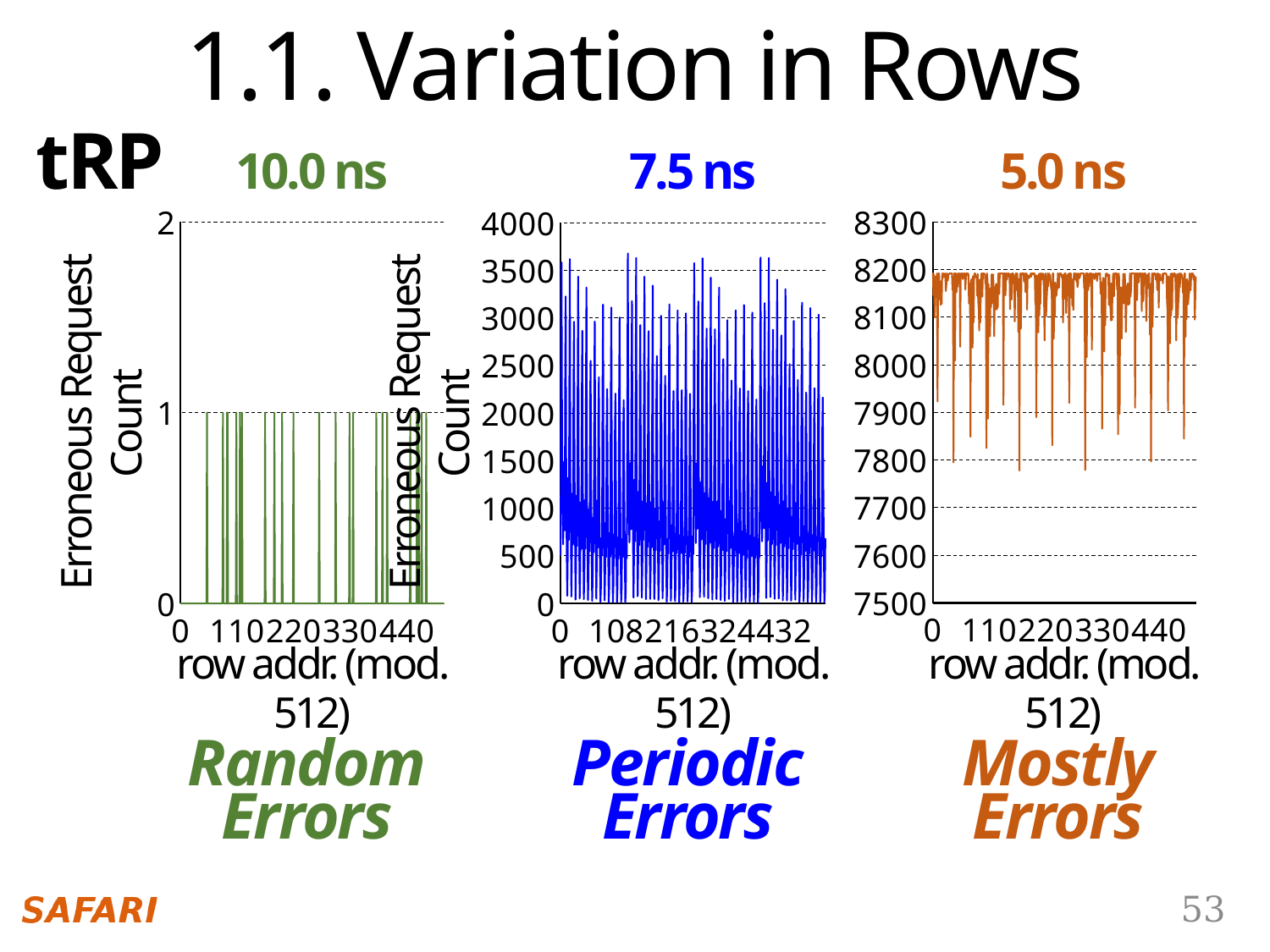
In the 10.0 ns chart, what is the top value shown on the y axis? 2 What label is given to the x axis of the 7.5 ns chart? row addr. (mod. 512) In the 5.0 ns chart, what is the lowest value shown on the y axis? 7500 Which of the three charts shows the highest erroneous request counts: 10.0 ns, 7.5 ns or 5.0 ns? 5.0 ns What caption describes the error pattern in the 7.5 ns chart? Periodic Errors In the 7.5 ns chart, is the highest peak greater or less than 3500? greater In the 7.5 ns chart, is the highest peak greater or less than 4000? less In the 10.0 ns chart, what is the highest erroneous request count reached by any row? 1 What kind of chart is used for the 7.5 ns panel? line chart How many charts are shown on the slide? 3 In the 5.0 ns chart, is the lowest dip greater or less than 7900? less